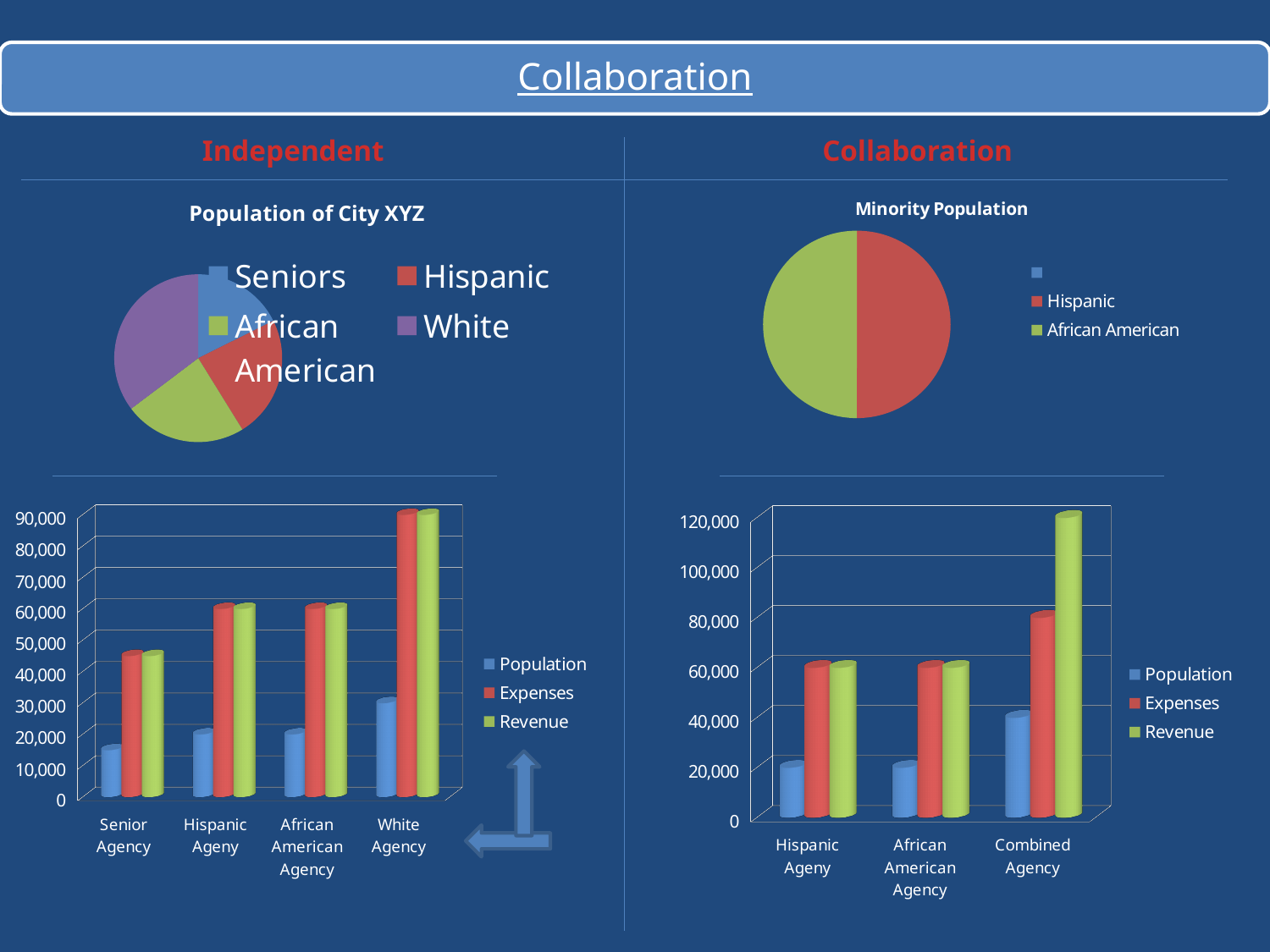
In the bottom-left bar chart, which agency has the lowest Population? Senior Agency In the bottom-right bar chart, is the Revenue value for Combined Agency greater or less than 100,000? greater In the bottom-right bar chart, is the Population value for Hispanic Ageny greater or less than 40,000? less In the bottom-left bar chart, which agency has the highest Revenue? White Agency In the bottom-left bar chart, how many series does the legend list? 3 In the bottom-right bar chart, how many agency categories are shown on the x axis? 3 In the bottom-right bar chart, which is larger for Combined Agency: Expenses or Revenue? Revenue What are the legend entries of the 'Population of City XYZ' pie chart? Seniors, Hispanic, African American, White What kind of chart is the 'Minority Population' chart? pie chart In the bottom-left bar chart, is the Population value for Senior Agency greater or less than 20,000? less What kind of chart is the bottom-left chart showing Senior Agency, Hispanic Ageny, African American Agency and White Agency? bar chart In the bottom-left bar chart, how many agency categories are shown on the x axis? 4